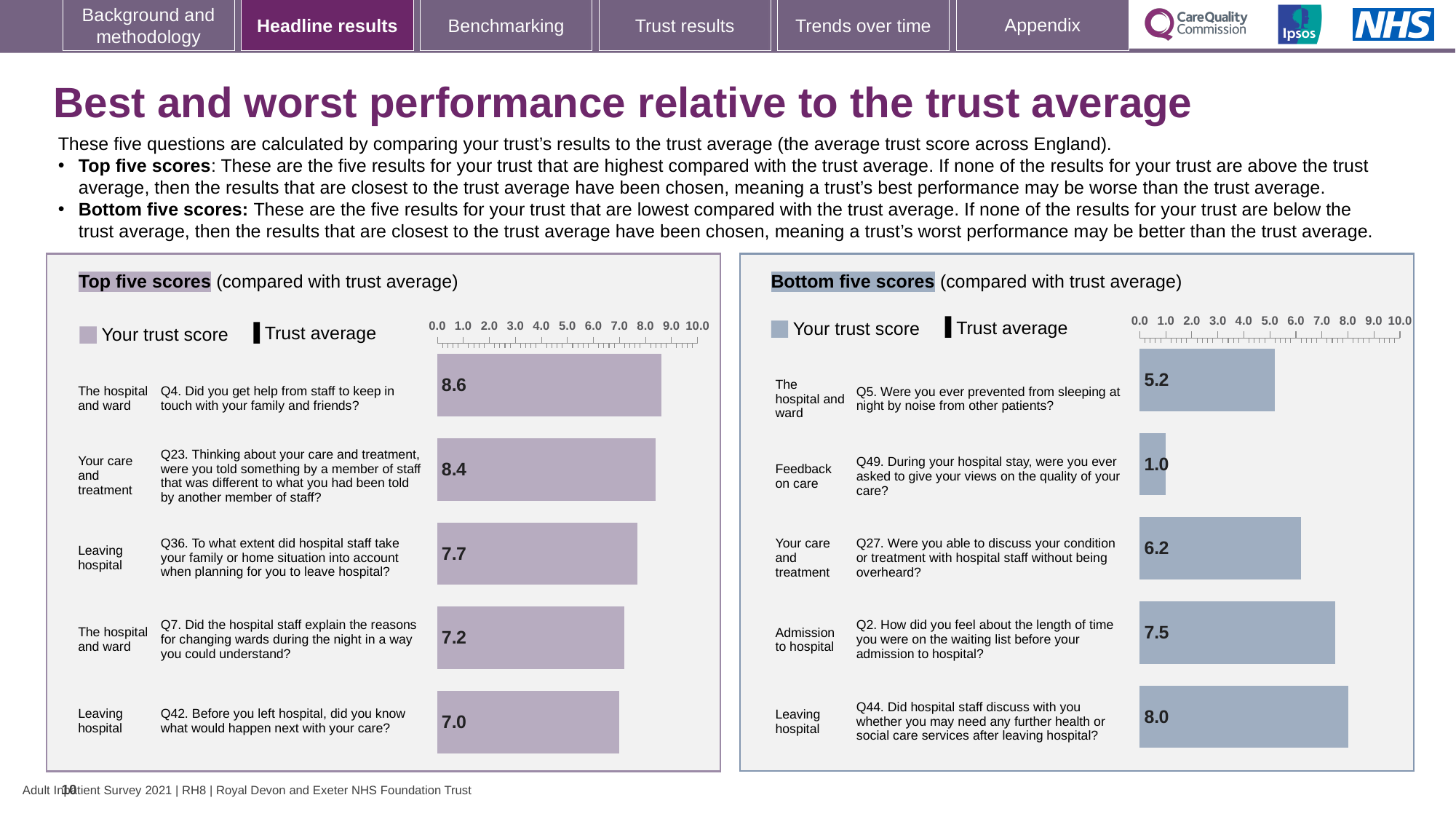
In the Bottom five scores chart, what is the trust score for Q49 (asked to give your views on the quality of your care)? 1.0 In the Top five scores chart, what is the difference between the trust scores for Q4 and Q42? 1.6 In the Top five scores chart, which question has the highest trust score? Q4 In the Top five scores chart, which has the larger trust score: Q23 or Q36? Q23 In the Bottom five scores chart, what is the difference between the trust scores for Q44 and Q5? 2.8 In the Top five scores chart, what is the trust score for Q42 (did you know what would happen next with your care)? 7.0 In the Top five scores chart, what is the trust score for Q4 (help from staff to keep in touch with family and friends)? 8.6 What kind of chart is used in the Top five scores panel? Bar chart In the Bottom five scores chart, which question has the lowest trust score? Q49 In the Bottom five scores chart, which question has the highest trust score? Q44 In the Bottom five scores chart, what is the trust score for Q2 (length of time on the waiting list before admission)? 7.5 How many bars are plotted in the Bottom five scores chart? 5